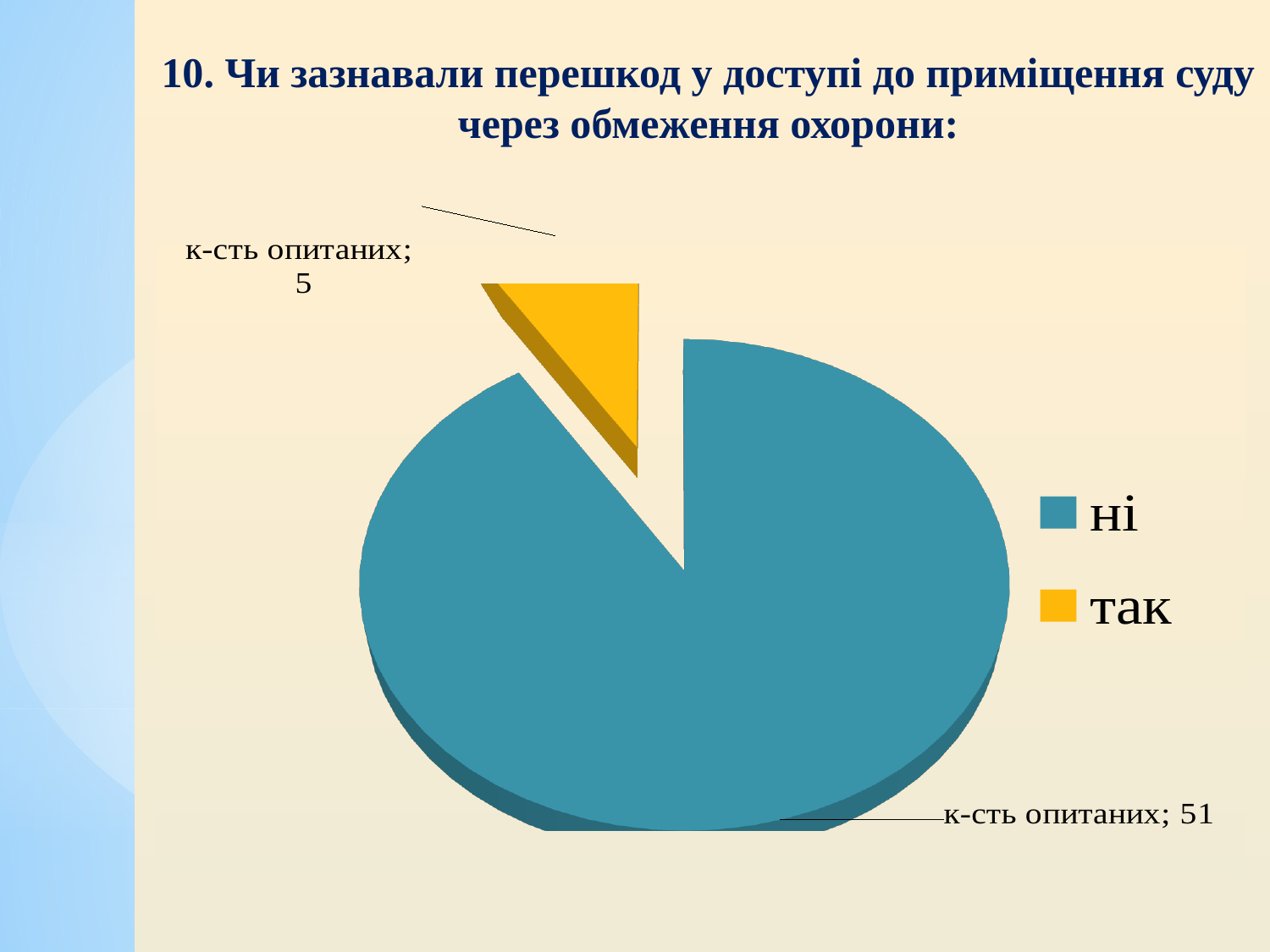
What is the total of all slices in the pie chart? 56 Which slice is the smallest? так What is the difference between the values for "ні" and "так"? 46 What series name appears in the data labels of the pie chart? к-сть опитаних What is the value for the "так" slice? 5 Which is larger, the value for "ні" or the value for "так"? ні What share of the total does the "так" slice represent? 5 out of 56 What kind of chart is shown on the slide? pie chart How many slices does the pie chart have? 2 What is the value for the "ні" slice? 51 Which slice is the largest? ні What colour is the "так" slice? yellow